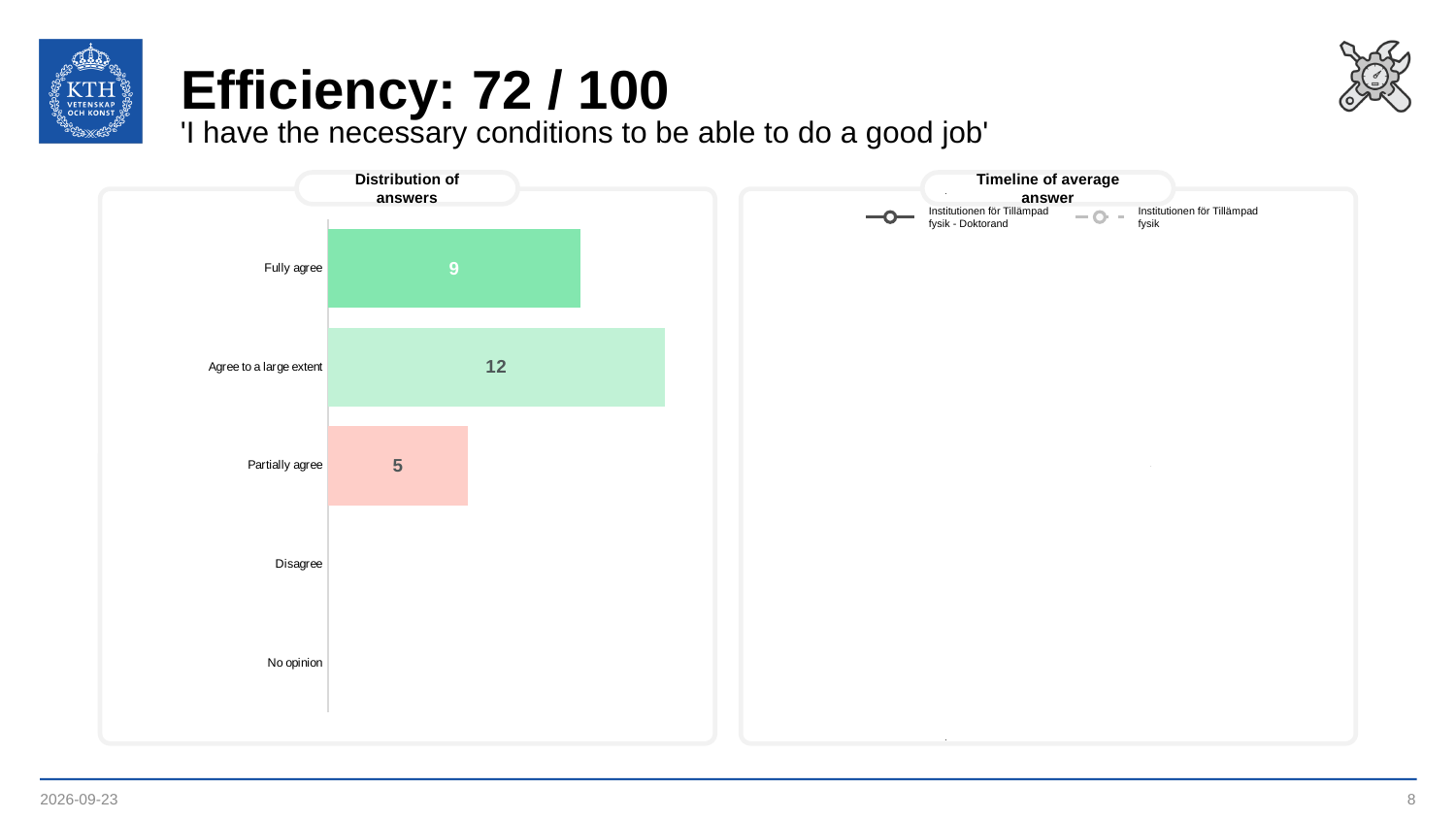
In the 'Distribution of answers' chart, what is the value for 'Agree to a large extent'? 12 In the 'Distribution of answers' chart, which of the three categories with a bar has the lowest value? Partially agree In the 'Distribution of answers' chart, which category has the highest value? Agree to a large extent In the 'Distribution of answers' chart, what is the value for 'Partially agree'? 5 How many series does the legend of the 'Timeline of average answer' chart list? 2 What kind of chart is the 'Distribution of answers' chart? Bar chart How many categories are listed on the axis of the 'Distribution of answers' chart? 5 What is the title of the chart on the left side of the slide? Distribution of answers In the 'Distribution of answers' chart, which is larger: the value for 'Fully agree' or the value for 'Partially agree'? Fully agree In the 'Distribution of answers' chart, what is the difference between the values for 'Fully agree' and 'Partially agree'? 4 In the 'Distribution of answers' chart, what is the value for 'Fully agree'? 9 In the 'Distribution of answers' chart, what is the difference between the values for 'Agree to a large extent' and 'Fully agree'? 3